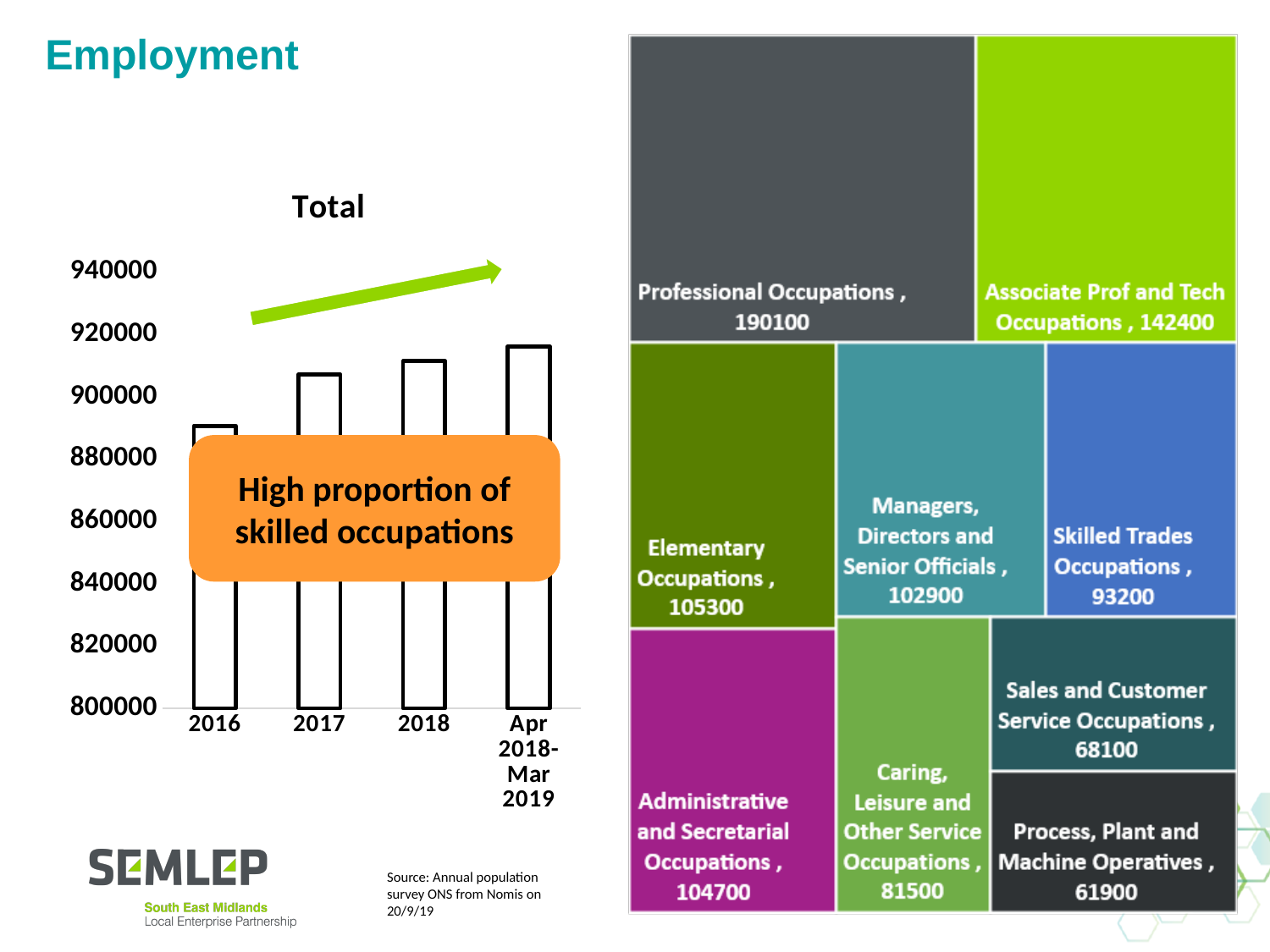
In the occupations treemap on the right, which is larger: Elementary Occupations or Administrative and Secretarial Occupations? Elementary Occupations In the 'Total' bar chart, is the value for Apr 2018-Mar 2019 greater or less than 900000? greater In the 'Total' bar chart, is the value for 2016 greater or less than 900000? less In the occupations treemap on the right, what is the value for Professional Occupations? 190100 In the 'Total' bar chart, do the values rise or fall from 2016 to Apr 2018-Mar 2019? rise In the occupations treemap on the right, what is the value for Skilled Trades Occupations? 93200 In the 'Total' bar chart, which period has the lowest value? 2016 In the occupations treemap on the right, which occupation group has the smallest value? Process, Plant and Machine Operatives In the 'Total' bar chart, how many bars are plotted? 4 In the occupations treemap on the right, what is the difference between Professional Occupations and Associate Prof and Tech Occupations? 47700 In the occupations treemap on the right, how many occupation groups are shown? 9 What type of chart is the 'Total' chart on the left of the slide? bar chart